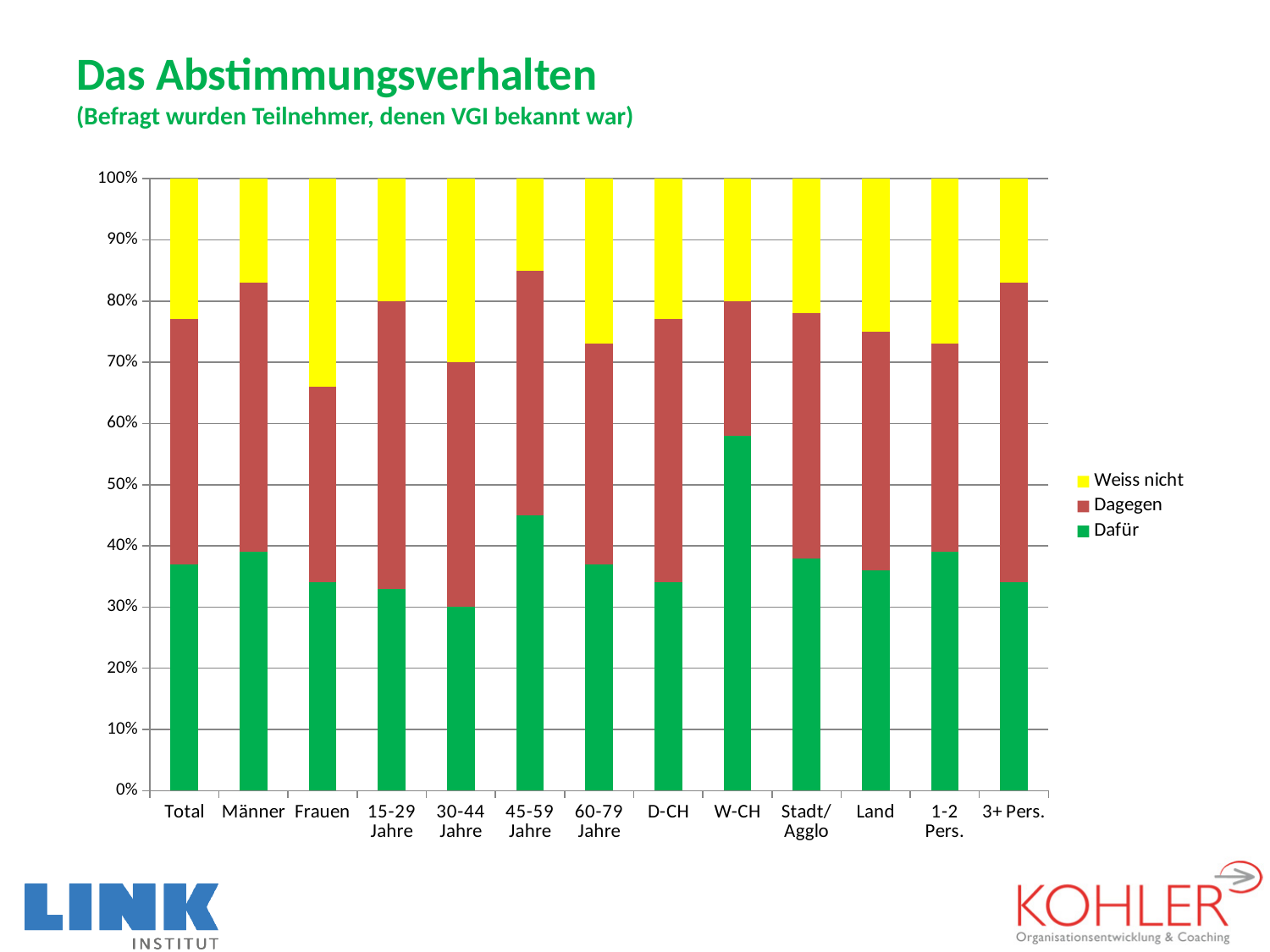
Which has a larger Dafür share, W-CH or D-CH? W-CH What is the title of the slide? Das Abstimmungsverhalten Is the Dafür value for 45-59 Jahre greater or less than 40%? greater Which category has the highest share of Dafür? W-CH How many series does the legend list? 3 Which has a larger Dafür share, Männer or Frauen? Männer What is the total height of each stacked bar, as shown by the top of the axis? 100% How many categories are shown along the x axis? 13 What kind of chart is shown on the slide? Stacked bar chart Is the Dafür value for 30-44 Jahre greater or less than 40%? less Which colour represents the Weiss nicht series in the legend? Yellow Is the Dafür value for W-CH greater or less than 50%? greater